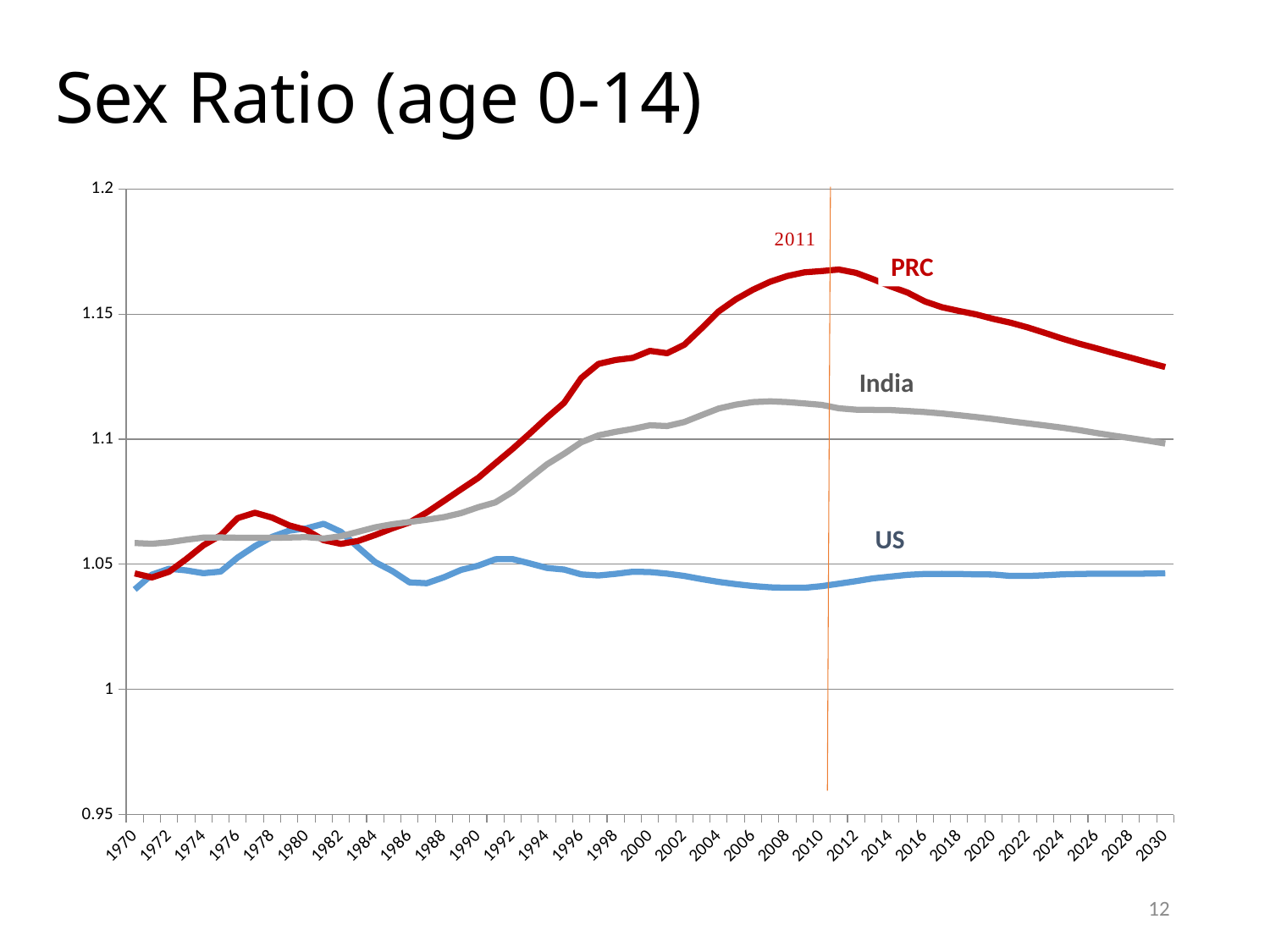
Does the PRC line rise or fall between 2011 and 2030? fall What is the title of the chart? Sex Ratio (age 0-14) Is the value for PRC in 2011 greater or less than 1.15? greater Does the PRC line rise or fall between 1990 and 2010? rise Which series has the highest value in 2030? PRC Is the value for US in 2030 greater or less than 1.05? less Which year is marked by the vertical line on the chart? 2011 Which series has the lowest value in 2030? US In 2020, which is larger: the value for PRC or the value for India? PRC Is the value for India in 2006 greater or less than 1.1? greater How many series are plotted on the chart? 3 What kind of chart is shown on the slide? line chart